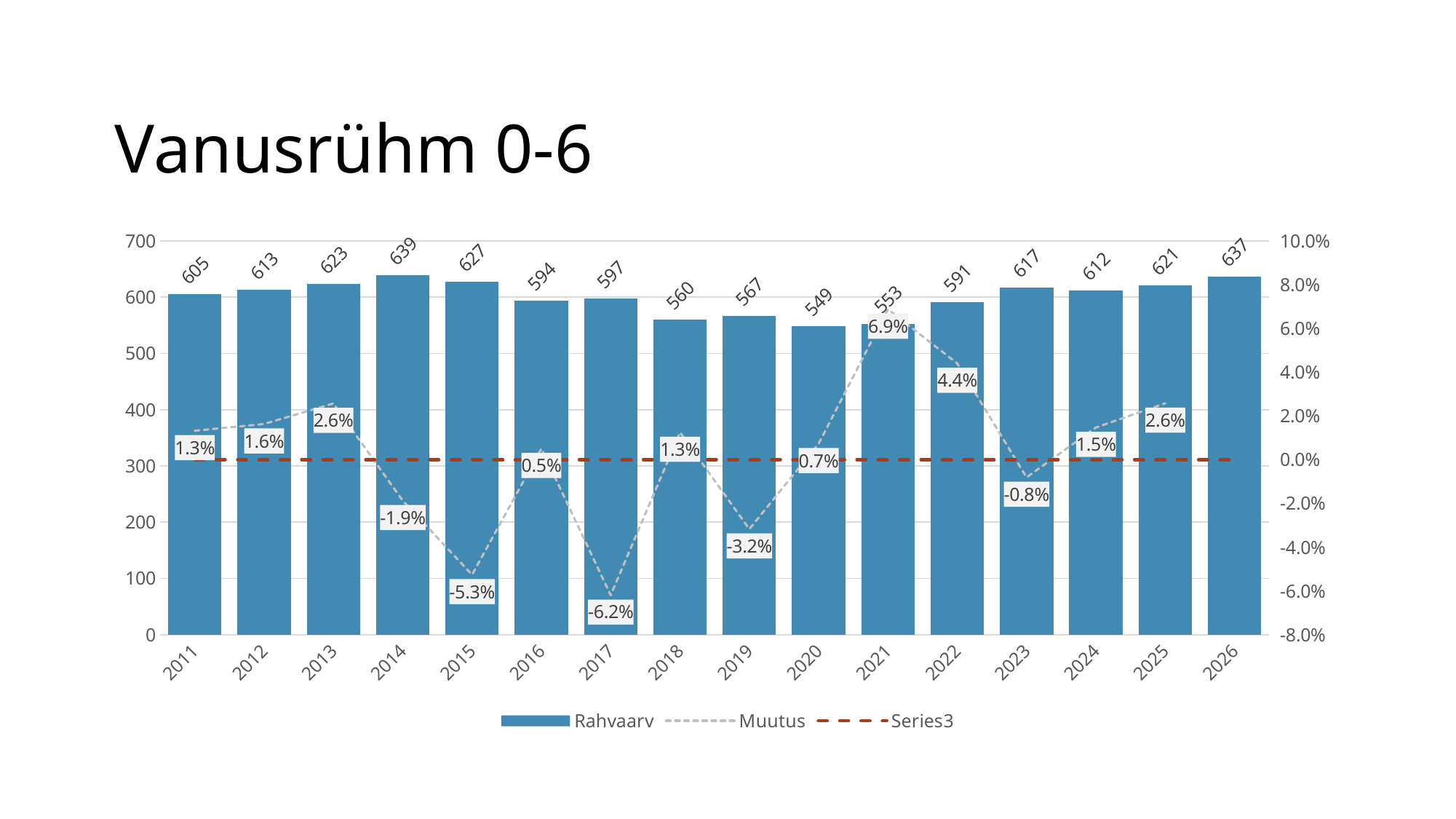
What is the Rahvaarv value for 2014? 639 Which year has the highest Rahvaarv value? 2014 What is the Rahvaarv value for 2020? 549 How many years are shown on the x axis? 16 Which is larger, the Rahvaarv value for 2013 or for 2023? 2013 How many series does the legend list? 3 Is the Rahvaarv value for 2018 greater or less than 600? less Do the Rahvaarv values rise or fall from 2011 to 2014? rise What is the difference between the Rahvaarv values for 2026 and 2011? 32 What kind of chart is shown? Combined bar and line chart Which year has the lowest Rahvaarv value? 2020 What is the Rahvaarv value for 2026? 637